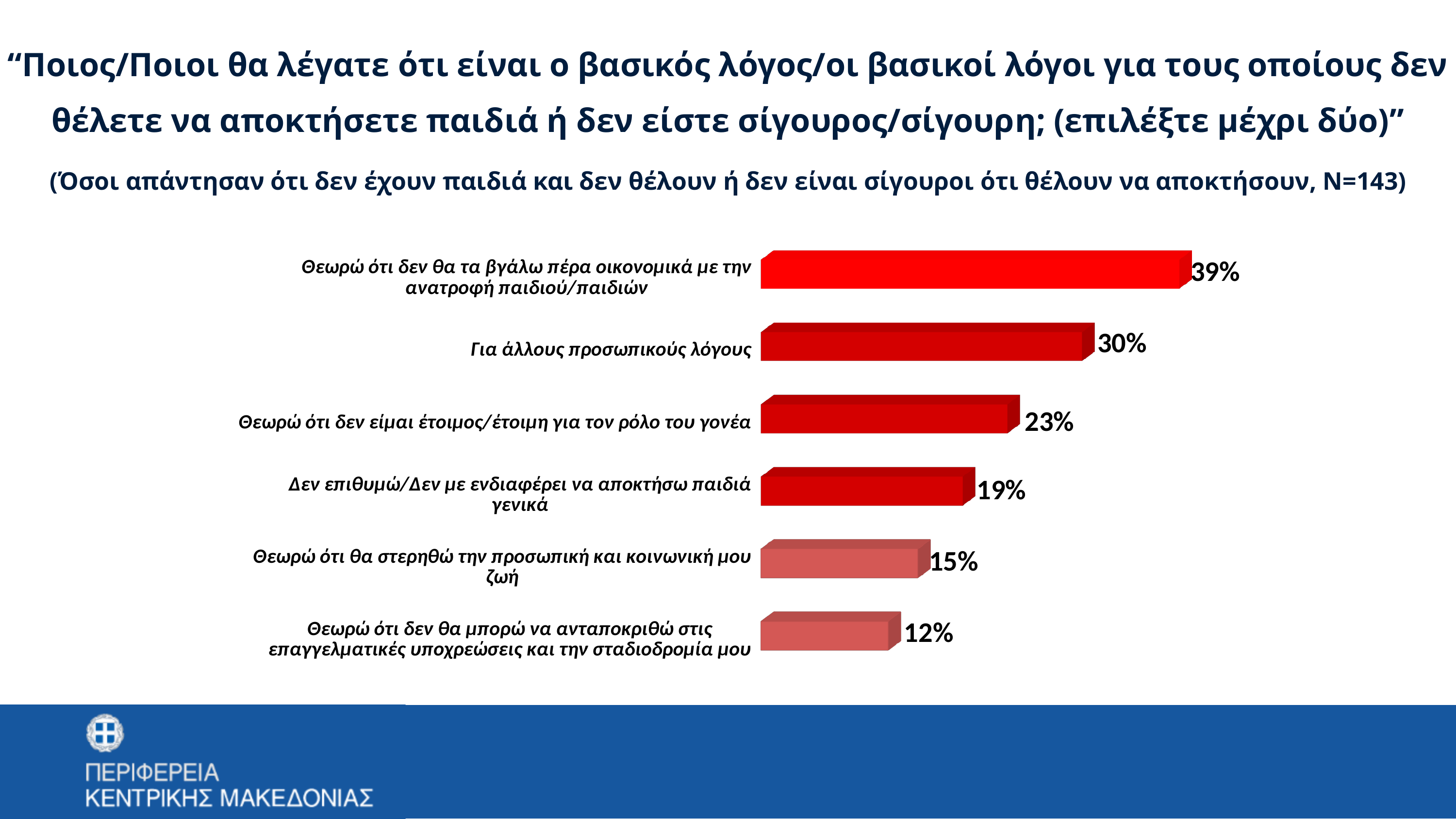
Which category has the highest value? Θεωρώ ότι δεν θα τα βγάλω πέρα οικονομικά με την ανατροφή παιδιού/παιδιών What is the difference between the value for "Δεν επιθυμώ/Δεν με ενδιαφέρει να αποκτήσω παιδιά γενικά" and the value for "Θεωρώ ότι δεν θα μπορώ να ανταποκριθώ στις επαγγελματικές υποχρεώσεις και την σταδιοδρομία μου"? 7% Which category has the lowest value? Θεωρώ ότι δεν θα μπορώ να ανταποκριθώ στις επαγγελματικές υποχρεώσεις και την σταδιοδρομία μου What is the value for "Για άλλους προσωπικούς λόγους"? 30% What kind of chart is shown on the slide? Bar chart How many categories are shown in the chart? 6 Are the bars in the chart arranged horizontally or vertically? Horizontally What is the value for "Θεωρώ ότι θα στερηθώ την προσωπική και κοινωνική μου ζωή"? 15% What is the difference between the value for "Θεωρώ ότι δεν θα τα βγάλω πέρα οικονομικά με την ανατροφή παιδιού/παιδιών" and the value for "Για άλλους προσωπικούς λόγους"? 9% What is the sample size (N) stated in the subtitle of the slide? N=143 What is the value for "Θεωρώ ότι δεν είμαι έτοιμος/έτοιμη για τον ρόλο του γονέα"? 23% Which is larger: the value for "Θεωρώ ότι δεν είμαι έτοιμος/έτοιμη για τον ρόλο του γονέα" or the value for "Δεν επιθυμώ/Δεν με ενδιαφέρει να αποκτήσω παιδιά γενικά"? Θεωρώ ότι δεν είμαι έτοιμος/έτοιμη για τον ρόλο του γονέα